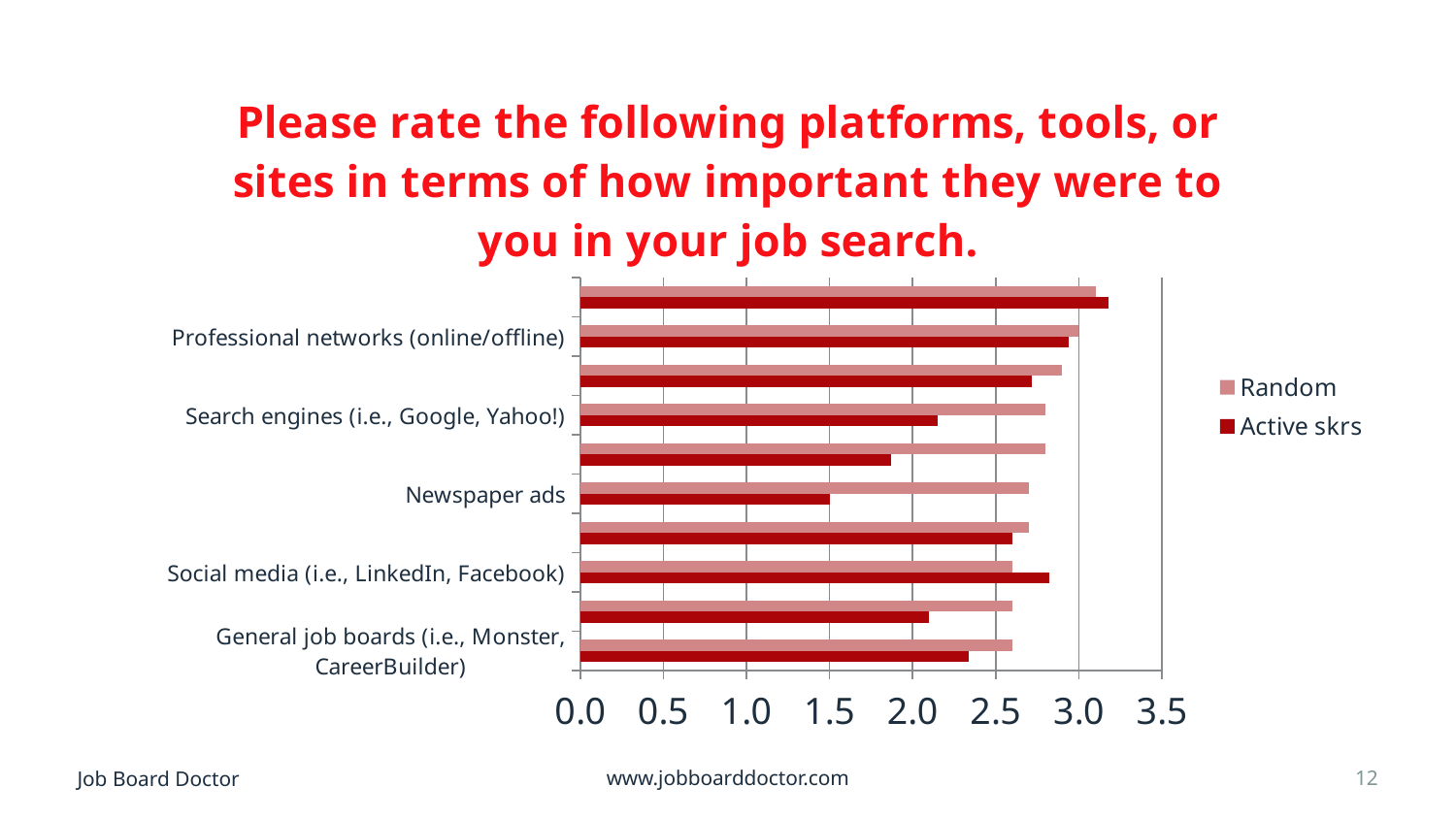
Which labeled category has the lowest Active skrs value? Newspaper ads How many series does the legend list? 2 What kind of chart is shown on the slide? bar chart What is the highest value shown on the horizontal axis? 3.5 For Newspaper ads, which series has the larger value, Random or Active skrs? Random For Social media (i.e., LinkedIn, Facebook), which series has the larger value, Random or Active skrs? Active skrs Is the Active skrs value for General job boards (i.e., Monster, CareerBuilder) greater or less than 2.5? less Is the Random value for Newspaper ads greater or less than 2.5? greater Is the Active skrs value for Newspaper ads greater or less than 2.0? less What are the two series named in the legend? Random and Active skrs